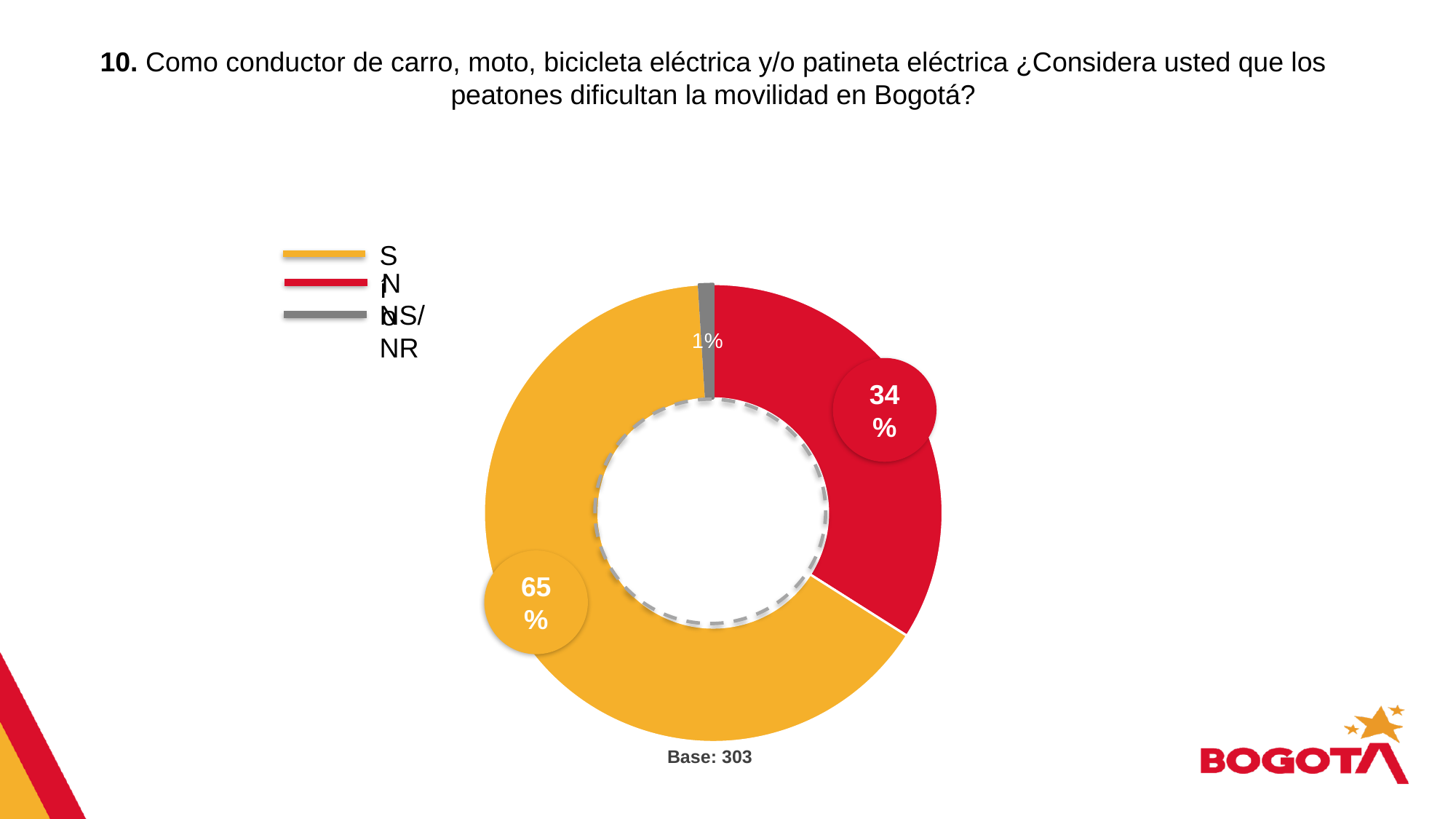
What percentage of respondents answered "NS/NR"? 1% Which is larger, the share for "No" or the share for "NS/NR"? No What percentage of respondents answered "No"? 34% What is the difference in percentage points between the "Sí" and "No" responses? 31 Which response has the smallest share of the chart? NS/NR Which response has the largest share of the chart? Sí What colour is the slice for "No"? Red How many entries does the legend list? 3 How many slices does the chart have? 3 What kind of chart is shown on the slide? Pie chart (donut) What percentage of respondents answered "Sí"? 65% What is the base (number of respondents) shown below the chart? 303